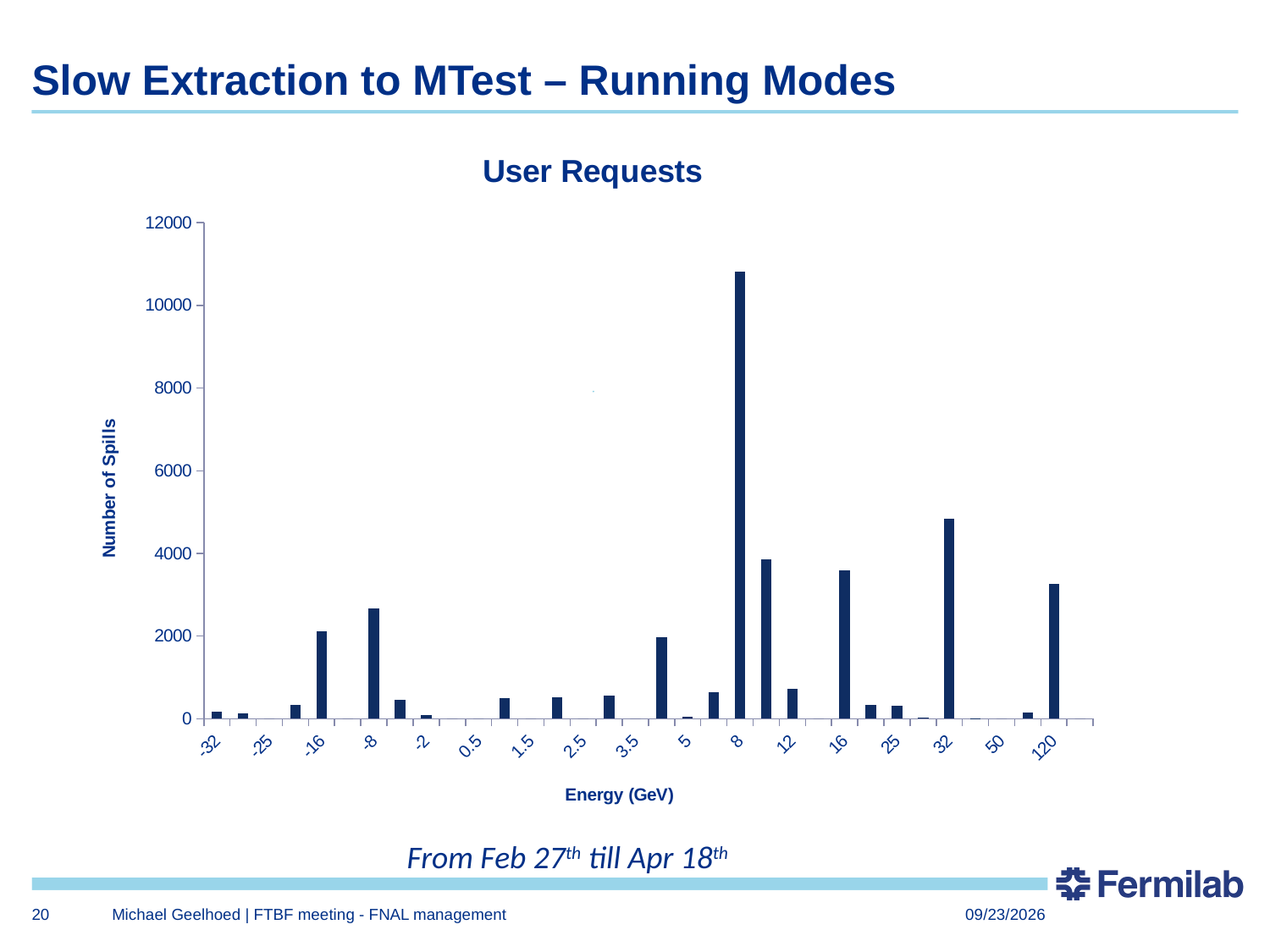
Which has more spills, -8 GeV or -16 GeV? -8 GeV What is the label of the vertical axis? Number of Spills What kind of chart is shown on the slide? bar chart Which energy has the highest number of spills? 8 Is the number of spills at 8 GeV greater or less than 10000? greater Which has more spills, 32 GeV or 16 GeV? 32 GeV Is the number of spills at 32 GeV greater or less than 4000? greater Is the number of spills at 16 GeV greater or less than 4000? less What is the title of the chart? User Requests Which has more spills, 8 GeV or 32 GeV? 8 GeV